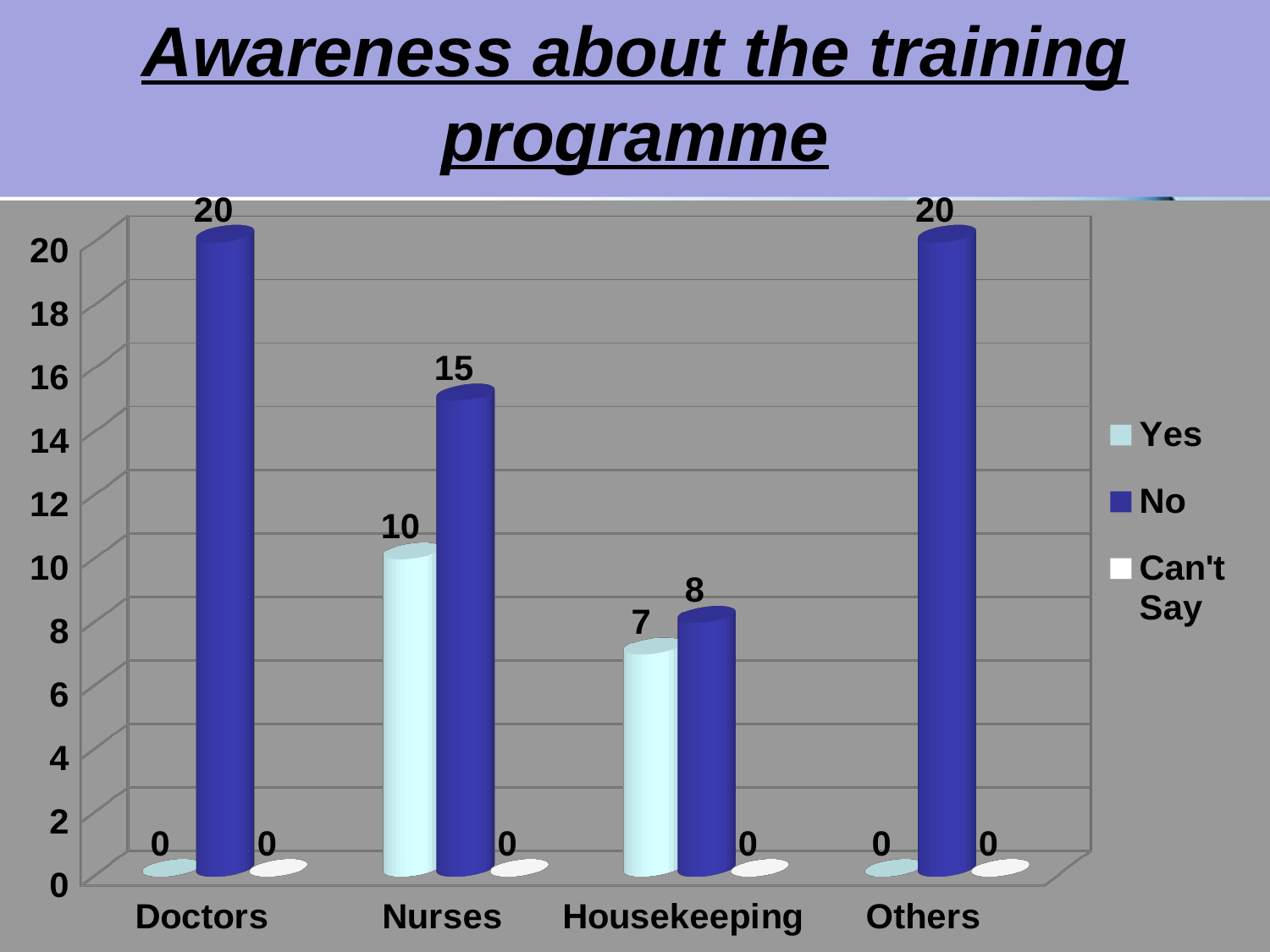
What is the 'Yes' value for Doctors? 0 Which is larger: the 'No' value for Doctors or the 'No' value for Nurses? Doctors What is the title of the chart? Awareness about the training programme How many series does the legend list? 3 How many categories are shown on the x axis? 4 What is the 'Can't Say' value for Others? 0 What is the difference between the 'No' and 'Yes' values for Nurses? 5 Which category has the highest 'Yes' value? Nurses Which category has the lowest 'No' value? Housekeeping What is the 'Yes' value for Housekeeping? 7 What is the 'No' value for Nurses? 15 What kind of chart is shown on the slide? Bar chart